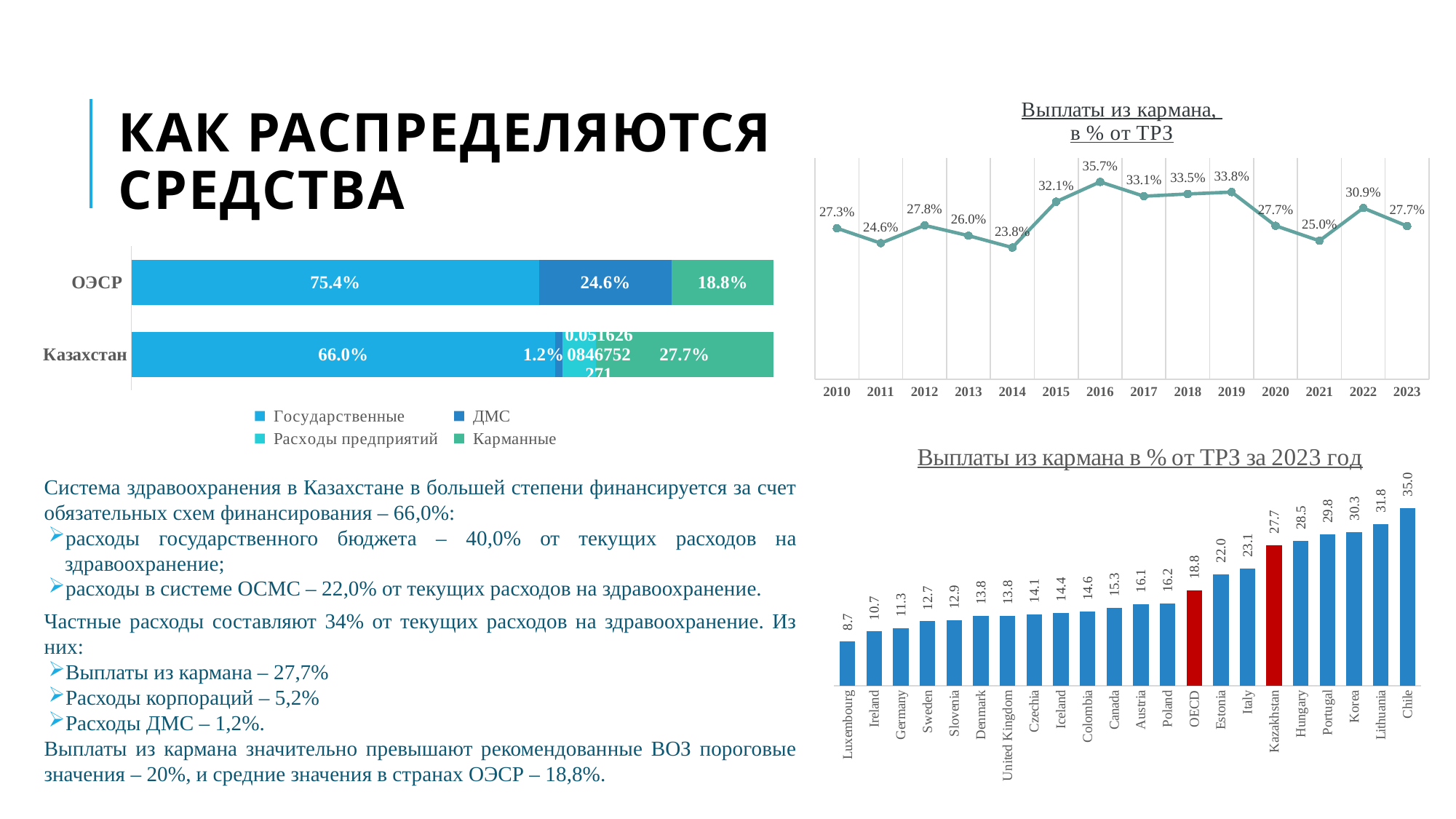
In the stacked bar chart on the left, what is the 'Государственные' share for ОЭСР? 75.4% In the bar chart 'Выплаты из кармана в % от ТРЗ за 2023 год', what is the value for Kazakhstan? 27.7 In the line chart 'Выплаты из кармана, в % от ТРЗ', which year has the highest value? 2016 In the line chart 'Выплаты из кармана, в % от ТРЗ', what is the value for 2016? 35.7% In the line chart 'Выплаты из кармана, в % от ТРЗ', how many years are plotted? 14 In the bar chart 'Выплаты из кармана в % от ТРЗ за 2023 год', which country has the highest value? Chile In the line chart 'Выплаты из кармана, в % от ТРЗ', do the values rise or fall from 2019 to 2021? fall In the bar chart 'Выплаты из кармана в % от ТРЗ за 2023 год', what is the difference between Kazakhstan and OECD? 8.9 In the line chart 'Выплаты из кармана, в % от ТРЗ', which year has the lowest value? 2014 In the line chart 'Выплаты из кармана, в % от ТРЗ', what is the difference between the 2022 and 2023 values? 3.2% In the stacked bar chart on the left, how many series does the legend list? 4 In the bar chart 'Выплаты из кармана в % от ТРЗ за 2023 год', which country has the lowest value? Luxembourg